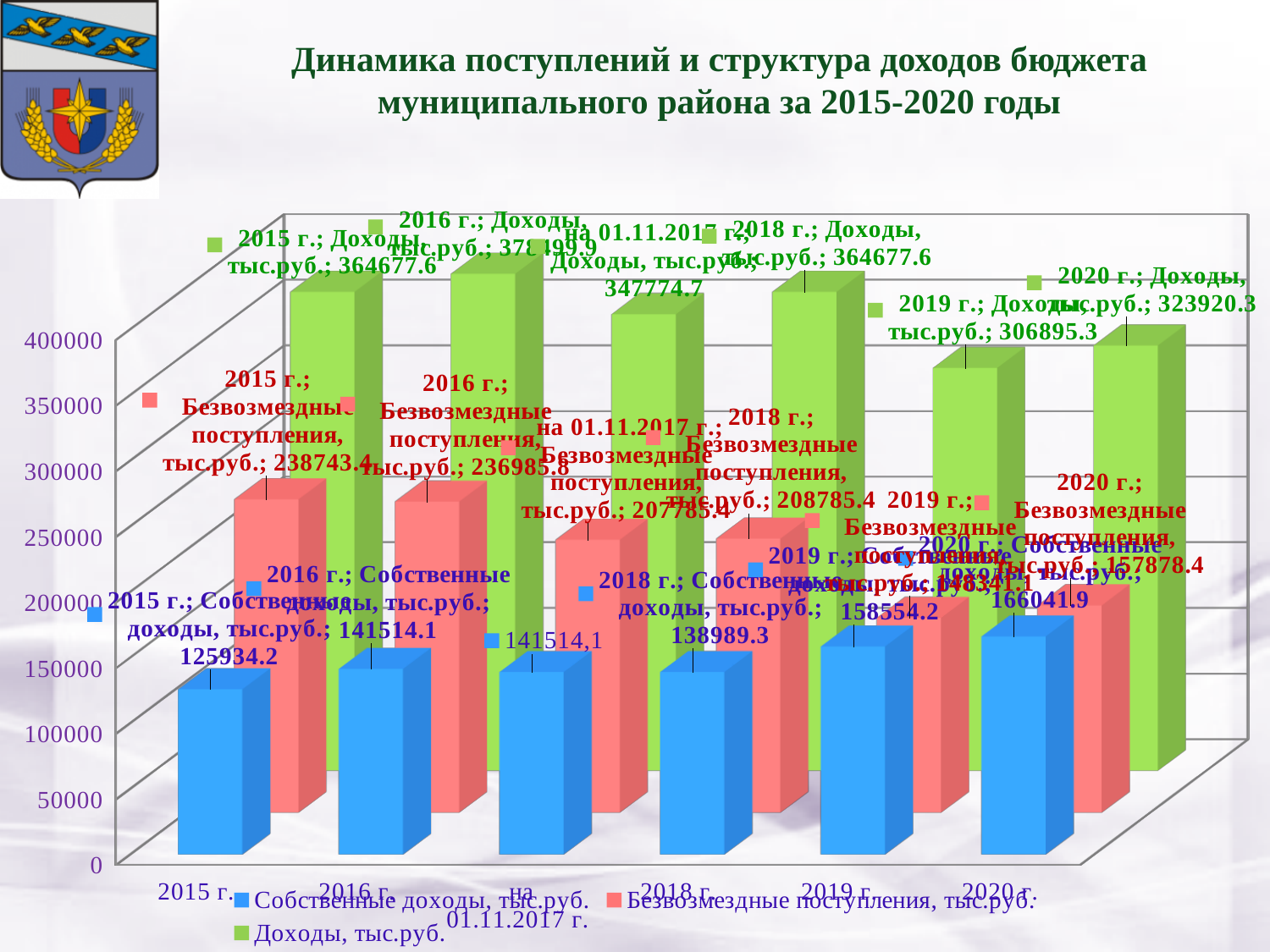
What is the value of Доходы, тыс.руб. for 2019 г.? 306895.3 What is the difference between Собственные доходы, тыс.руб. in 2020 г. and in 2015 г.? 40107.7 What is the value of Доходы, тыс.руб. for 2015 г.? 364677.6 In 2019 г., which is larger: Собственные доходы, тыс.руб. or Безвозмездные поступления, тыс.руб.? Собственные доходы, тыс.руб. How many categories (periods) are shown on the x axis? 6 Is the value of Собственные доходы, тыс.руб. for 2015 г. greater or less than 150000? less Which year has the lowest value of Собственные доходы, тыс.руб.? 2015 г. Which year has the highest value of Собственные доходы, тыс.руб.? 2020 г. Which year has the lowest value of Доходы, тыс.руб.? 2019 г. How many series does the legend list? 3 What is the value of Собственные доходы, тыс.руб. for 2020 г.? 166041.9 What is the value of Безвозмездные поступления, тыс.руб. for 2015 г.? 238743.4